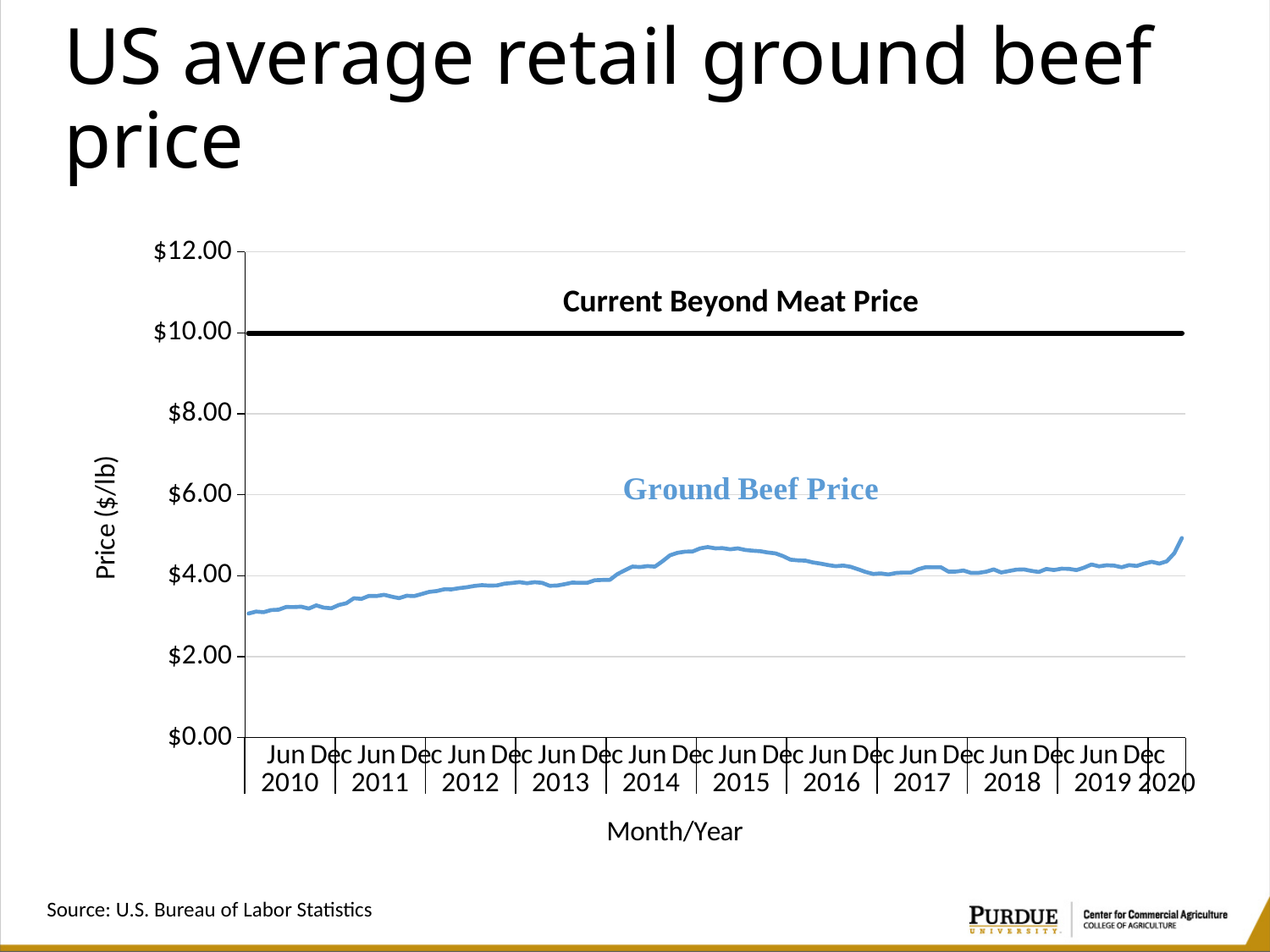
Is the Ground Beef Price at the end of the series in 2020 greater or less than $4.00? greater What source is cited for the chart data? U.S. Bureau of Labor Statistics Is the peak Ground Beef Price around 2015 greater or less than $6.00? less Is the Ground Beef Price in Jun 2010 greater or less than $4.00? less Does the Ground Beef Price rise or fall from 2010 to 2014? rise What is the label of the y axis? Price ($/lb) What kind of chart is shown on the slide? line chart How many years are labeled on the x axis? 11 How many data series are plotted on the chart? 2 Which is higher, the Current Beyond Meat Price or the Ground Beef Price? Current Beyond Meat Price